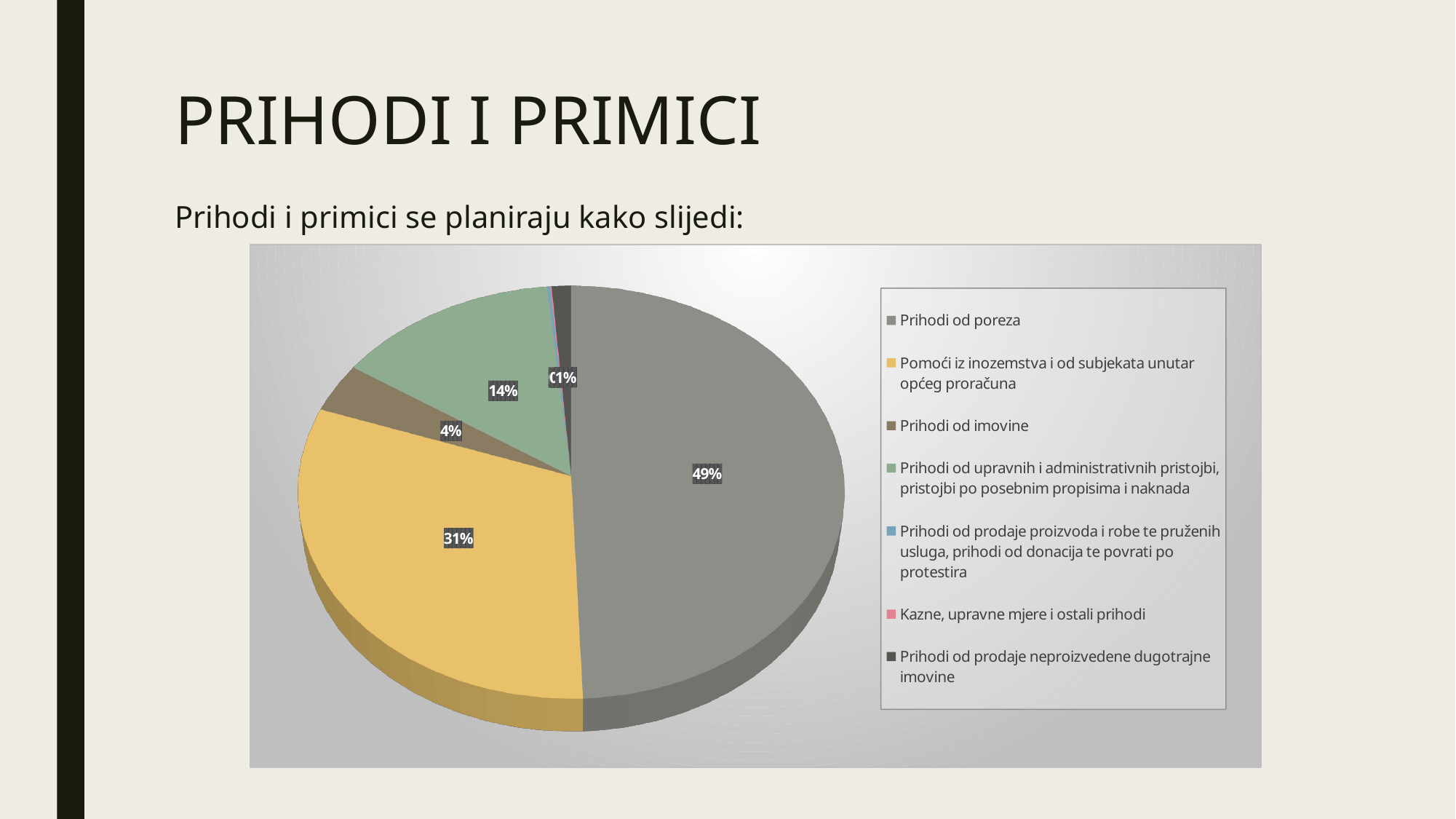
What is the value shown for Pomoći iz inozemstva i od subjekata unutar općeg proračuna? 31% What is the value shown for Prihodi od upravnih i administrativnih pristojbi, pristojbi po posebnim propisima i naknada? 14% How many categories does the legend list? 7 What kind of chart is shown on the slide? Pie chart What is the difference in percentage points between Prihodi od poreza and Pomoći iz inozemstva i od subjekata unutar općeg proračuna? 18 percentage points What colour is the slice for Prihodi od poreza? Grey Which category has the largest slice of the pie? Prihodi od poreza Which is larger: Pomoći iz inozemstva i od subjekata unutar općeg proračuna or Prihodi od upravnih i administrativnih pristojbi, pristojbi po posebnim propisima i naknada? Pomoći iz inozemstva i od subjekata unutar općeg proračuna What colour is the slice for Pomoći iz inozemstva i od subjekata unutar općeg proračuna? Yellow What is the difference in percentage points between Prihodi od upravnih i administrativnih pristojbi, pristojbi po posebnim propisima i naknada and Prihodi od imovine? 10 percentage points What share of the pie does Prihodi od poreza represent? 49% What is the value shown for Prihodi od imovine? 4%